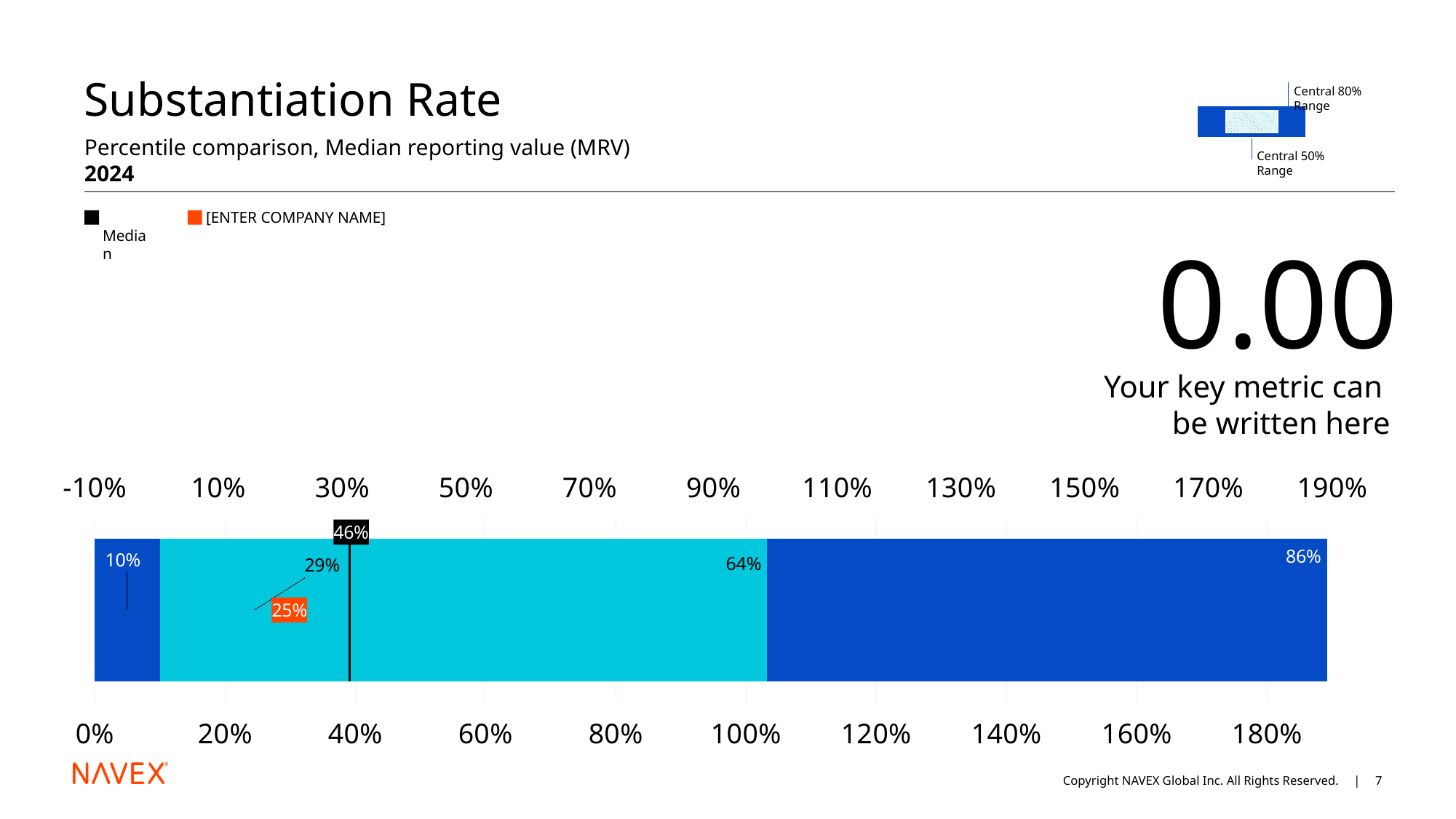
Which is larger, the median value or the [ENTER COMPANY NAME] value? Median What is the title of the chart? Substantiation Rate What kind of chart is shown on the slide? Bar chart How many percentile values are labelled on the bar (excluding the company marker)? 5 What is the lowest percentile value labelled on the bar? 10% Is the value for [ENTER COMPANY NAME] greater or less than 30%? less What is the highest percentile value labelled on the bar? 86% What is the difference between the 64% and 29% percentile labels on the bar? 35% What is the value shown for [ENTER COMPANY NAME]? 25% What is the difference between the median value and the [ENTER COMPANY NAME] value? 21% What is the median value shown on the chart? 46% How many entries does the legend list? 2